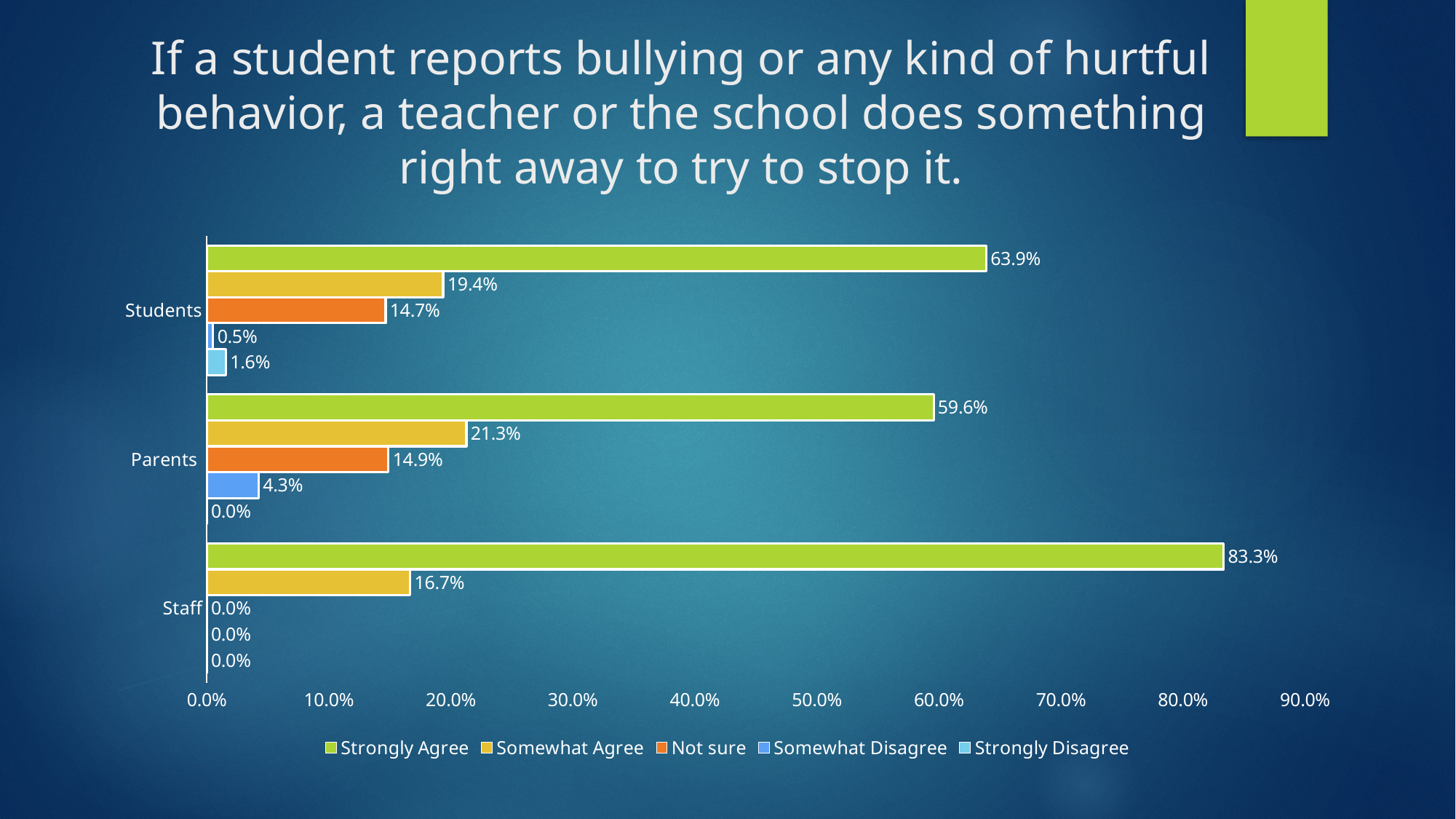
What percentage of Parents selected Somewhat Disagree? 4.3% What percentage of Staff selected Somewhat Agree? 16.7% What percentage of Students selected Strongly Agree? 63.9% How many series does the legend list? 5 Which group has the lowest Strongly Agree percentage? Parents Which colour represents the Not sure series in the legend? Orange What kind of chart is shown on the slide? Bar chart What is the difference between the Strongly Agree percentages for Staff and Students? 19.4% How many groups are shown on the y axis? 3 What percentage of Parents selected Somewhat Agree? 21.3% Which group has the highest Strongly Agree percentage? Staff Which is larger: the Somewhat Agree percentage for Parents or for Students? Parents